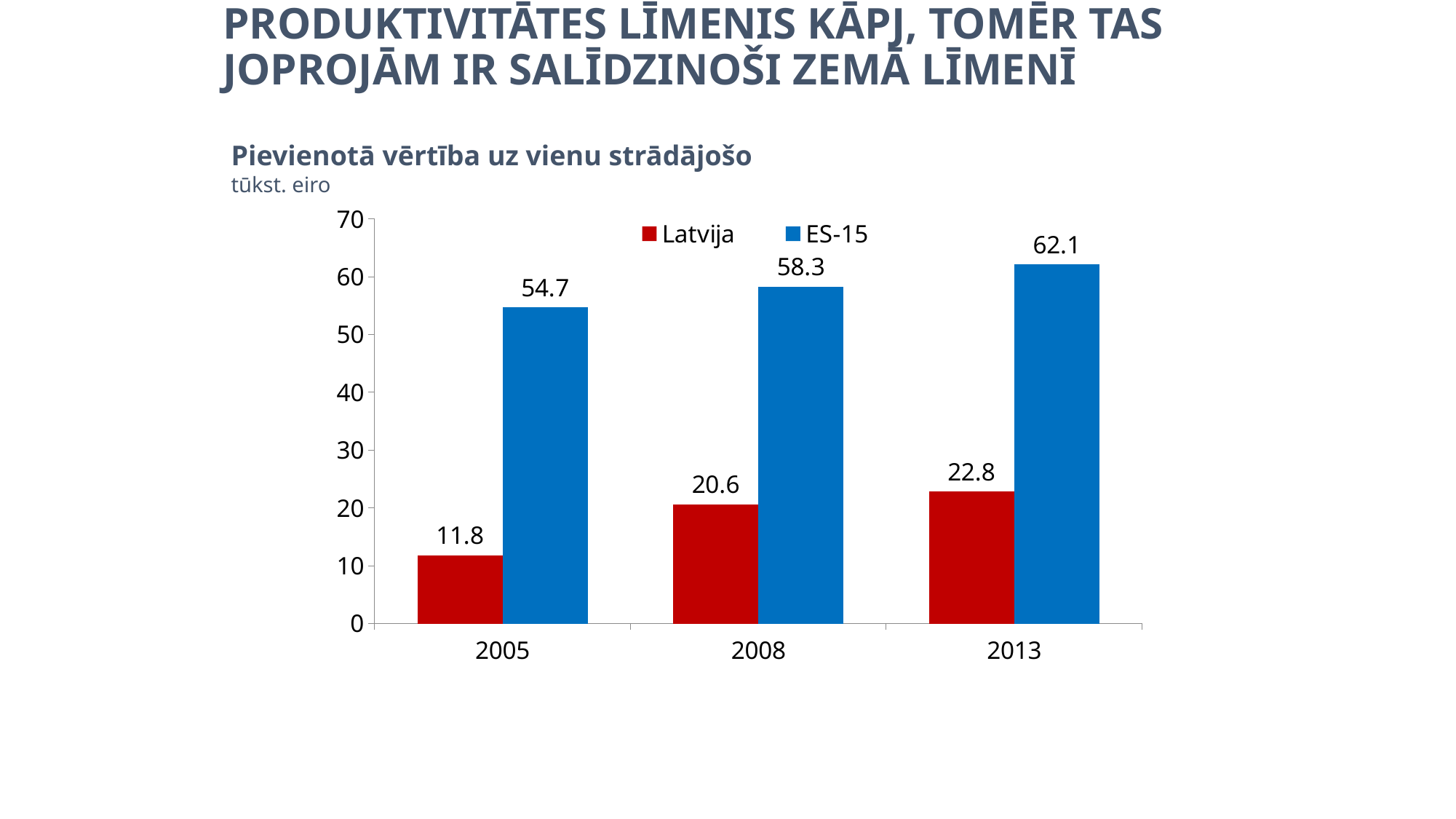
What is the difference between the Latvija values in 2008 and 2005? 8.8 In which year is the ES-15 value lowest? 2005 Do the Latvija values rise or fall from 2005 to 2013? Rise What kind of chart is shown on the slide? Bar chart What is the value for Latvija in 2005? 11.8 In which year is the Latvija value highest? 2013 Which is larger in 2008, the Latvija value or the ES-15 value? ES-15 What is the value for ES-15 in 2008? 58.3 What is the value for ES-15 in 2013? 62.1 How many years are shown on the x axis? 3 How many series does the legend list? 2 What is the difference between the ES-15 and Latvija values in 2013? 39.3